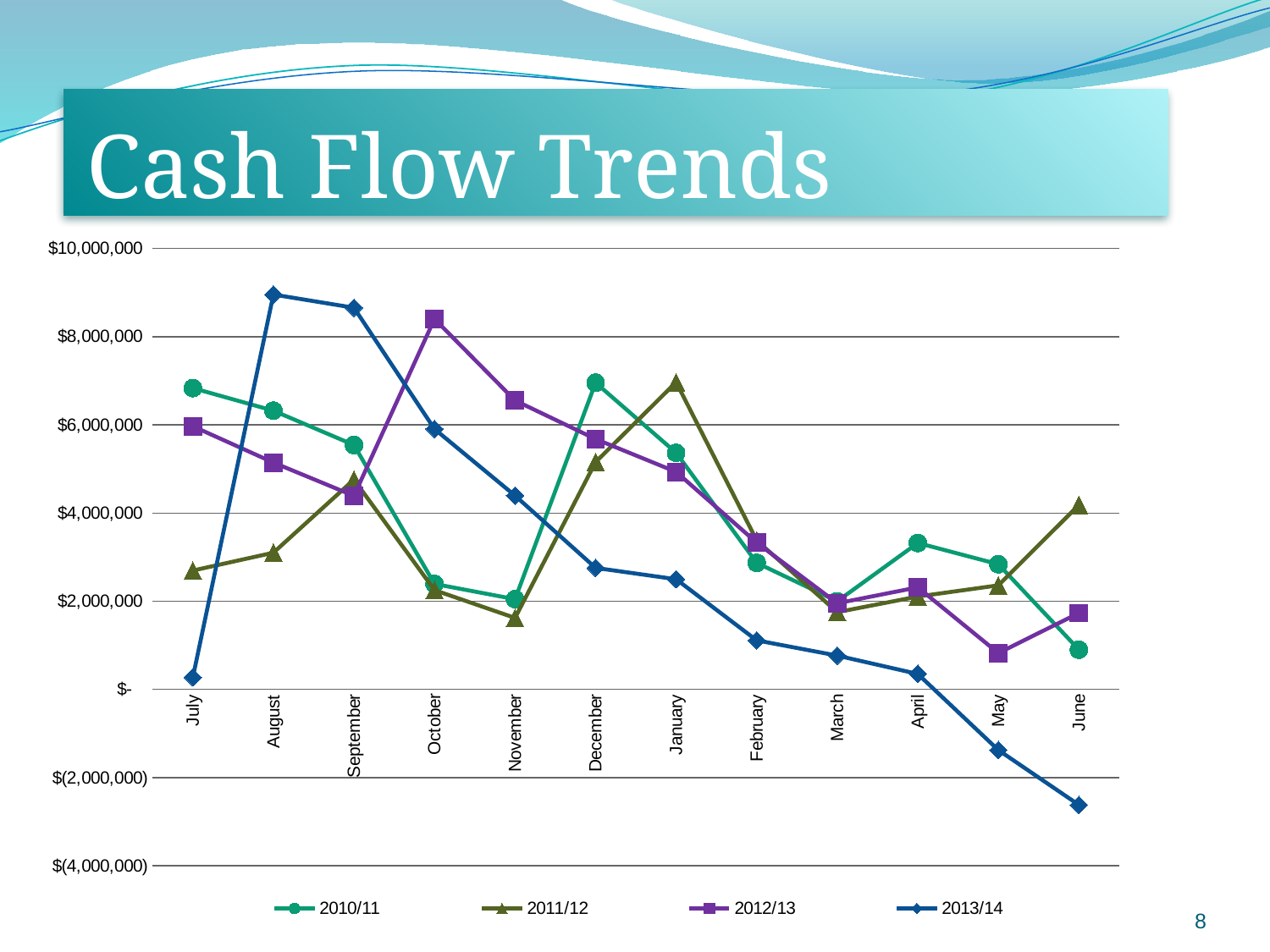
What type of chart is shown on the slide? Line chart How many months are plotted along the x axis? 12 How many series does the legend list? 4 In which month does the 2013/14 series reach its highest value? August Does the 2013/14 series rise or fall from August to June? Fall In which month does the 2010/11 series reach its lowest value? June Is the value for 2012/13 in October greater or less than $8,000,000? greater In which month does the 2011/12 series reach its highest value? January Is the value for 2013/14 in June greater or less than $(2,000,000)? less In which month does the 2013/14 series reach its lowest value? June In which month does the 2012/13 series reach its highest value? October In July, which series has the larger value, 2010/11 or 2011/12? 2010/11